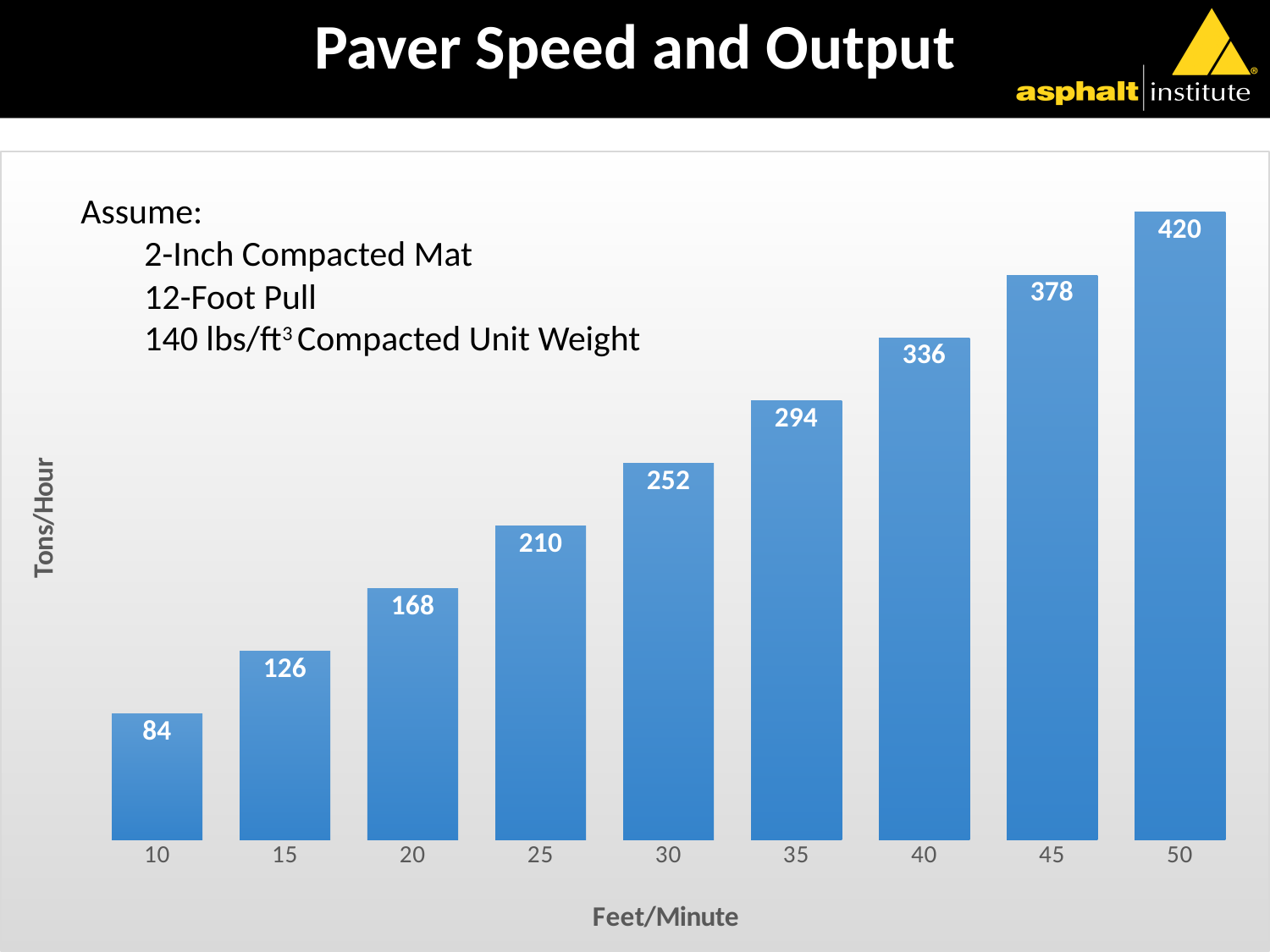
Which paver speed (feet/minute) has the highest output? 50 What is the title of the chart? Paver Speed and Output What kind of chart is shown on the slide? Bar chart Do the output values rise or fall as paver speed increases along the x axis? Rise What is the output in tons/hour at a paver speed of 10 feet/minute? 84 Which paver speed (feet/minute) has the lowest output? 10 What is the output in tons/hour at a paver speed of 30 feet/minute? 252 What is the output in tons/hour at a paver speed of 45 feet/minute? 378 How many paver speed categories are shown on the chart? 9 What is the difference in tons/hour between the output at 50 feet/minute and at 10 feet/minute? 336 Which has a larger output, 35 feet/minute or 40 feet/minute? 40 feet/minute What is the difference in tons/hour between the output at 25 feet/minute and at 20 feet/minute? 42